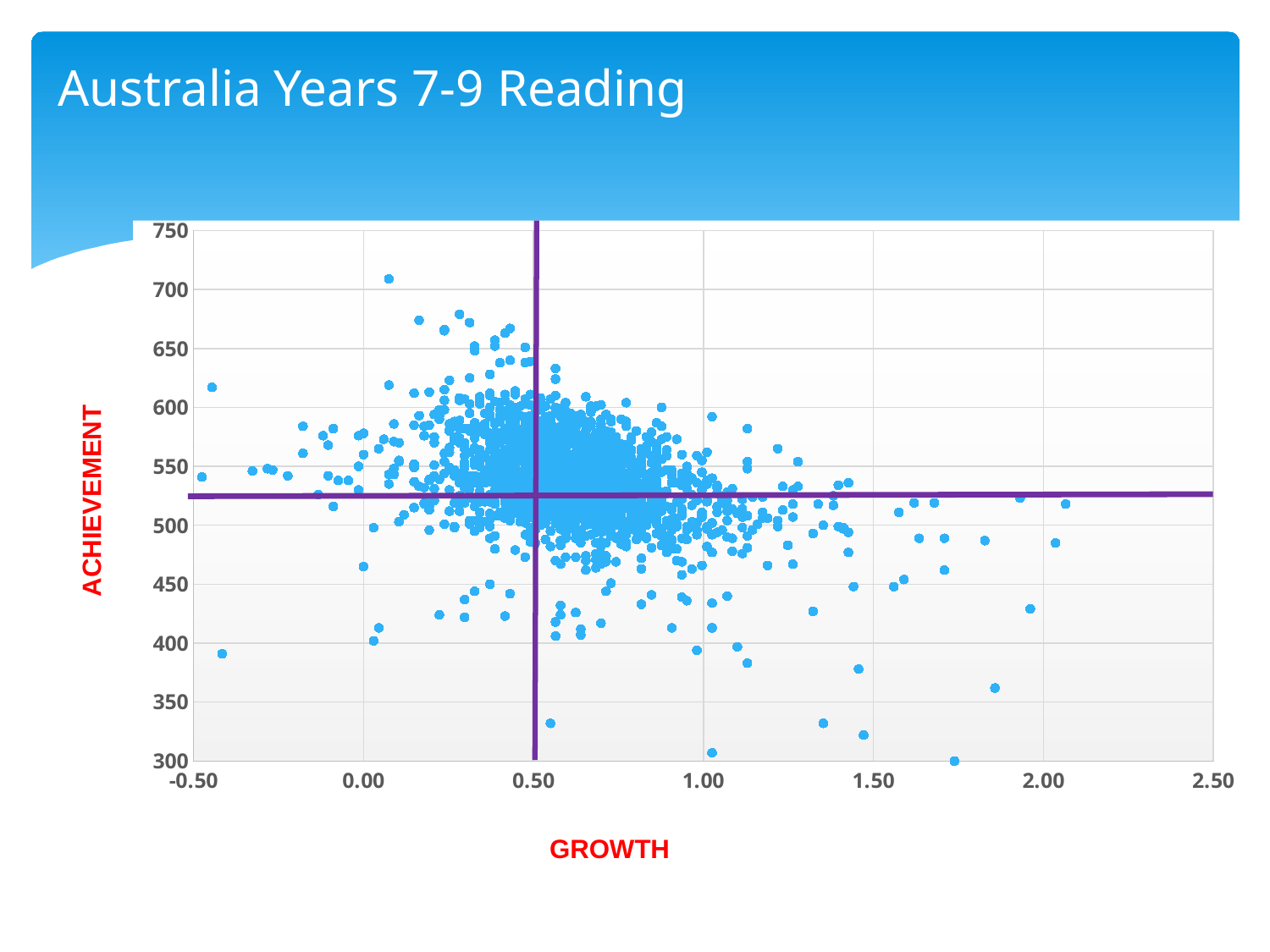
Is the lowest achievement value plotted greater or less than 350? less Is the horizontal purple line drawn at an achievement value greater or less than 500? greater Is the highest achievement value plotted greater or less than 700? greater What is the title of the chart? Australia Years 7-9 Reading At what growth value is the vertical purple line drawn? 0.50 What is the label on the horizontal (x) axis of the chart? GROWTH What is the minimum value shown on the growth (x) axis? -0.50 What kind of chart is shown on the slide? Scatter plot What is the maximum value shown on the achievement (y) axis? 750